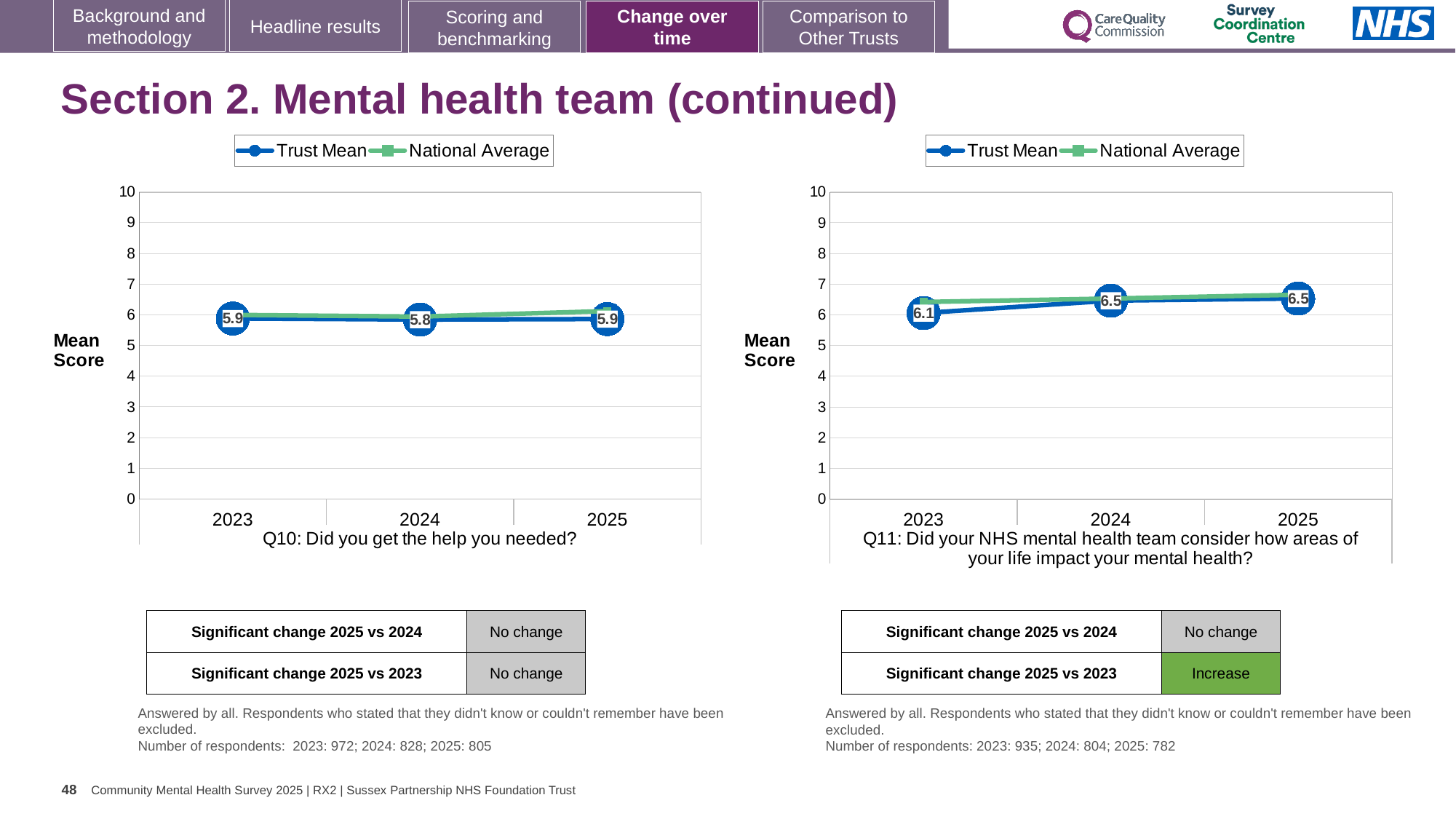
In the Q10 chart, is the Trust Mean for 2023 larger or smaller than the Trust Mean for 2024? larger In the Q11 chart, what is the Trust Mean for 2025? 6.5 In the Q11 chart, what is the Trust Mean for 2023? 6.1 In the Q10 chart, which year has the lowest Trust Mean? 2024 In the Q10 chart, what is the Trust Mean for 2025? 5.9 In the Q11 chart, what is the difference between the Trust Mean for 2025 and the Trust Mean for 2023? 0.4 In the Q10 chart, what is the Trust Mean for 2024? 5.8 In the Q11 chart, is the National Average for 2023 greater or less than 6? greater In the Q11 chart, does the Trust Mean rise or fall from 2023 to 2025? rise What kind of chart is the Q11 chart? line chart How many series does the legend of the Q10 chart list? 2 In the Q11 chart, which year has the lowest Trust Mean? 2023